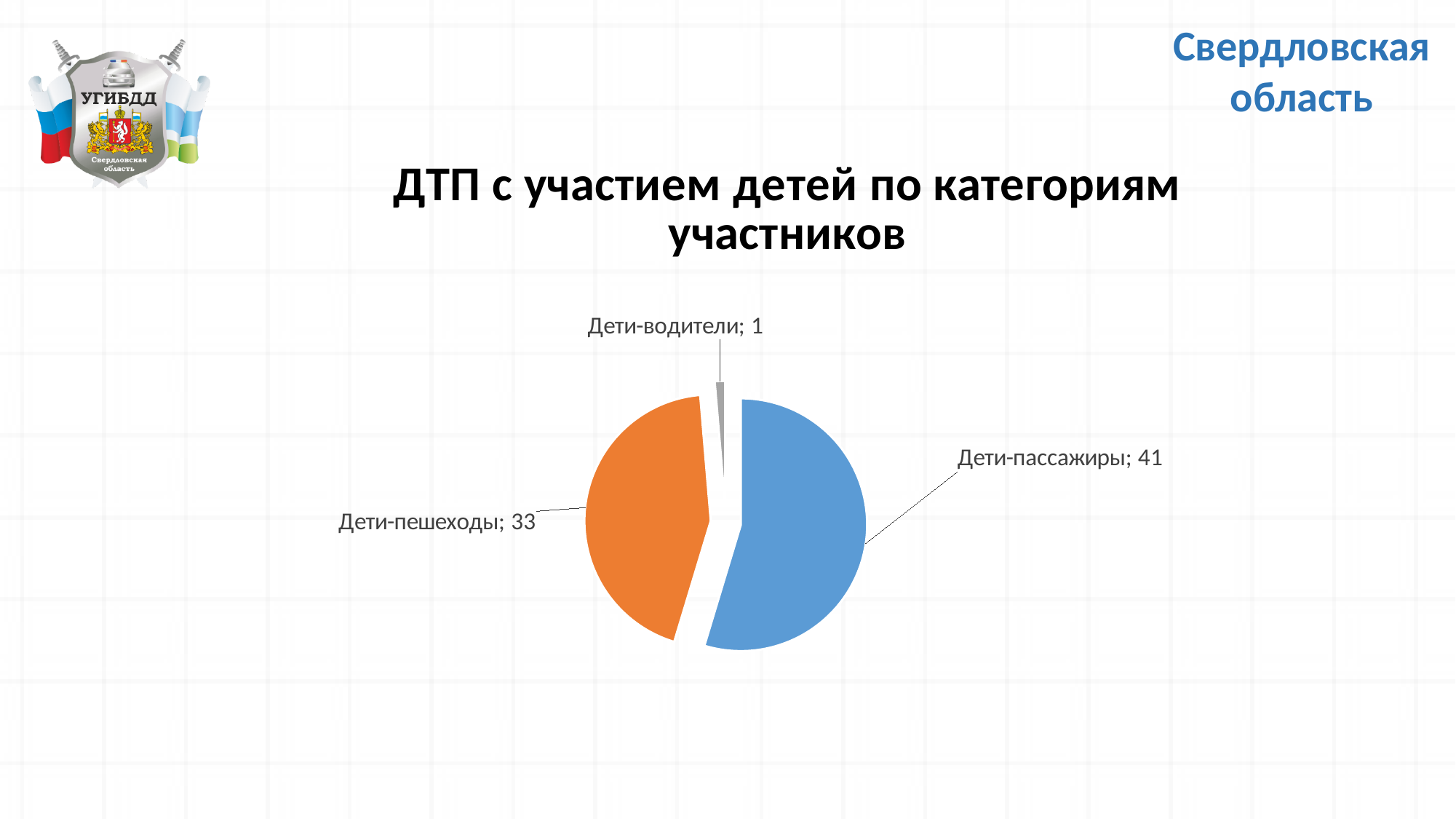
Which category has the smallest slice of the pie? Дети-водители What is the total of all slices in the pie chart? 75 What type of chart is shown on the slide? Pie chart What is the value for Дети-пассажиры? 41 What share of the pie does Дети-пешеходы represent? 44% How many categories are shown in the pie chart? 3 What is the title of the chart? ДТП с участием детей по категориям участников Which is larger, the value for Дети-пешеходы or the value for Дети-водители? Дети-пешеходы What is the difference between the values for Дети-пассажиры and Дети-пешеходы? 8 Which category has the largest slice of the pie? Дети-пассажиры What is the value for Дети-водители? 1 What is the value for Дети-пешеходы? 33